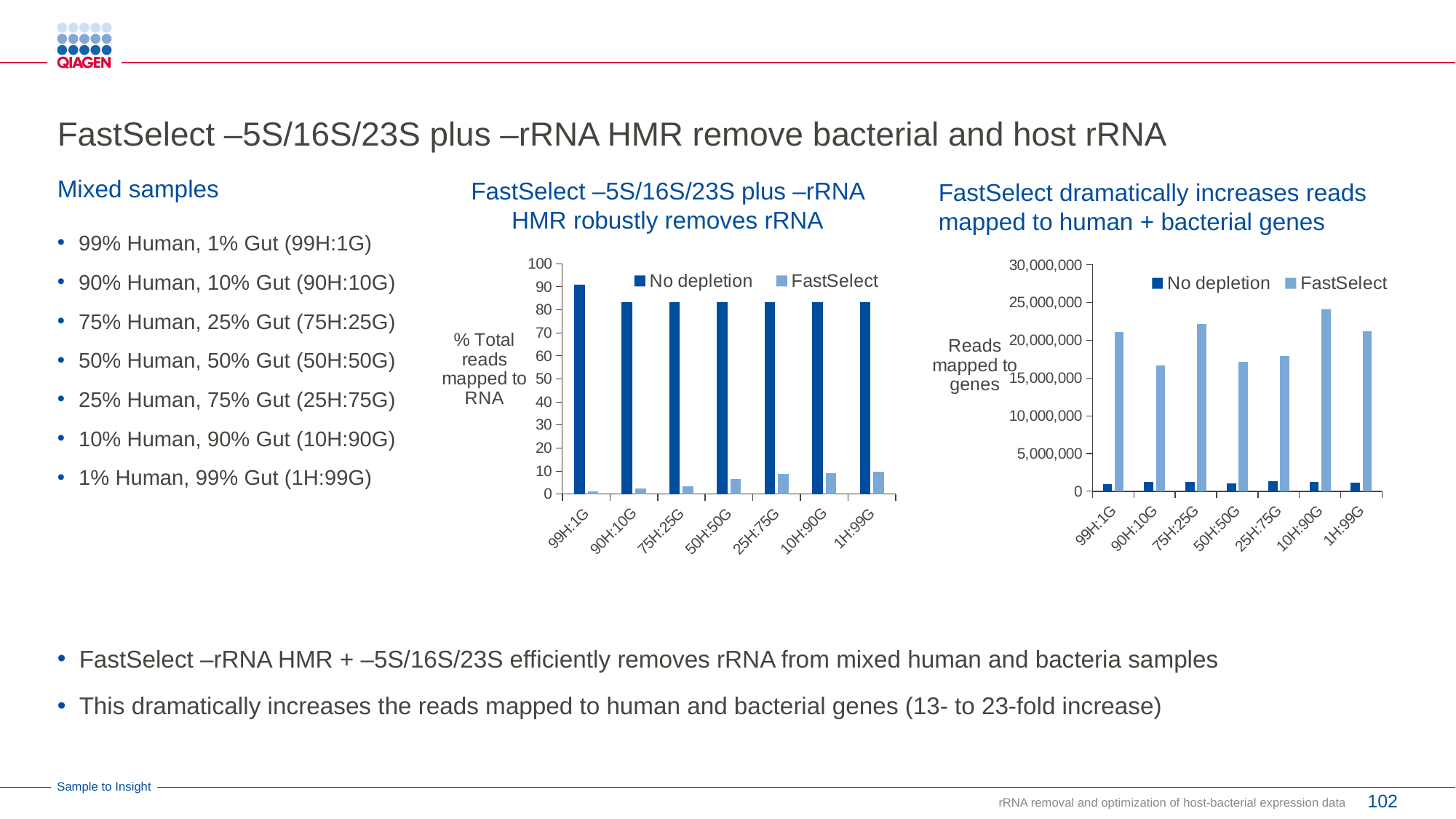
In the left chart (% Total reads mapped to RNA), do the FastSelect values rise or fall moving from 99H:1G to 1H:99G? Rise In the right chart (Reads mapped to genes), is the FastSelect value for 10H:90G greater or less than 20,000,000? greater In the left chart (% Total reads mapped to RNA), is the No depletion value for 50H:50G greater or less than 80? greater In the left chart (% Total reads mapped to RNA), is the FastSelect value for 1H:99G greater or less than 20? less In the left chart (% Total reads mapped to RNA), which category has the lowest FastSelect value? 99H:1G In the left chart (FastSelect –5S/16S/23S plus –rRNA HMR robustly removes rRNA), what kind of chart is shown? Bar chart In the left chart (% Total reads mapped to RNA), which category has the highest No depletion value? 99H:1G In the right chart (Reads mapped to genes), which category has the highest FastSelect value? 10H:90G In the right chart (Reads mapped to genes), what is the label of the y axis? Reads mapped to genes In the right chart (Reads mapped to genes), which is larger for 75H:25G, the No depletion value or the FastSelect value? FastSelect In the left chart (% Total reads mapped to RNA), how many series does the legend list? 2 In the left chart (% Total reads mapped to RNA), how many sample categories are shown on the x axis? 7